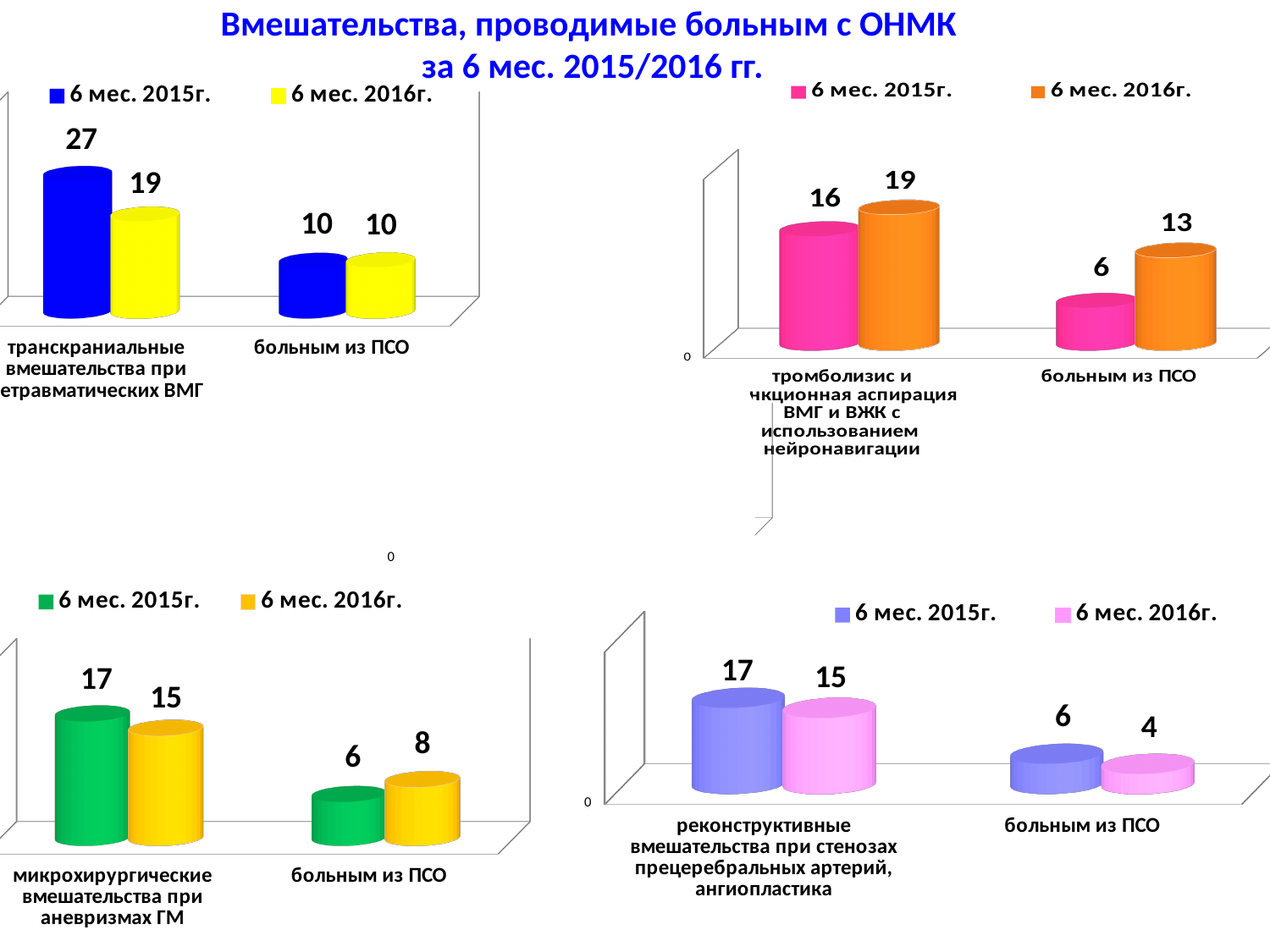
In the bottom-right chart, which series has the larger value for 'реконструктивные вмешательства при стенозах прецеребральных артерий, ангиопластика', '6 мес. 2015г.' or '6 мес. 2016г.'? 6 мес. 2015г. In the top-left chart, what is the difference between the '6 мес. 2015г.' and '6 мес. 2016г.' values for 'транскраниальные вмешательства при нетравматических ВМГ'? 8 In the top-right chart, what is the difference between the '6 мес. 2016г.' and '6 мес. 2015г.' values for 'больным из ПСО'? 7 In the bottom-right chart, what is the value for '6 мес. 2016г.' for 'больным из ПСО'? 4 In the top-right chart, what is the value for '6 мес. 2016г.' for 'больным из ПСО'? 13 What kind of chart is the top-left chart? Bar chart How many series does the legend of the bottom-right chart list? 2 In the top-left chart, what is the value for '6 мес. 2015г.' for 'транскраниальные вмешательства при нетравматических ВМГ'? 27 In the top-right chart, which series has the larger value for 'тромболизис и пункционная аспирация ВМГ и ВЖК с использованием нейронавигации', '6 мес. 2015г.' or '6 мес. 2016г.'? 6 мес. 2016г. In the bottom-left chart, what is the value for '6 мес. 2015г.' for 'микрохирургические вмешательства при аневризмах ГМ'? 17 In the top-left chart, what is the value for '6 мес. 2016г.' for 'больным из ПСО'? 10 In the bottom-left chart, what is the value for '6 мес. 2016г.' for 'больным из ПСО'? 8